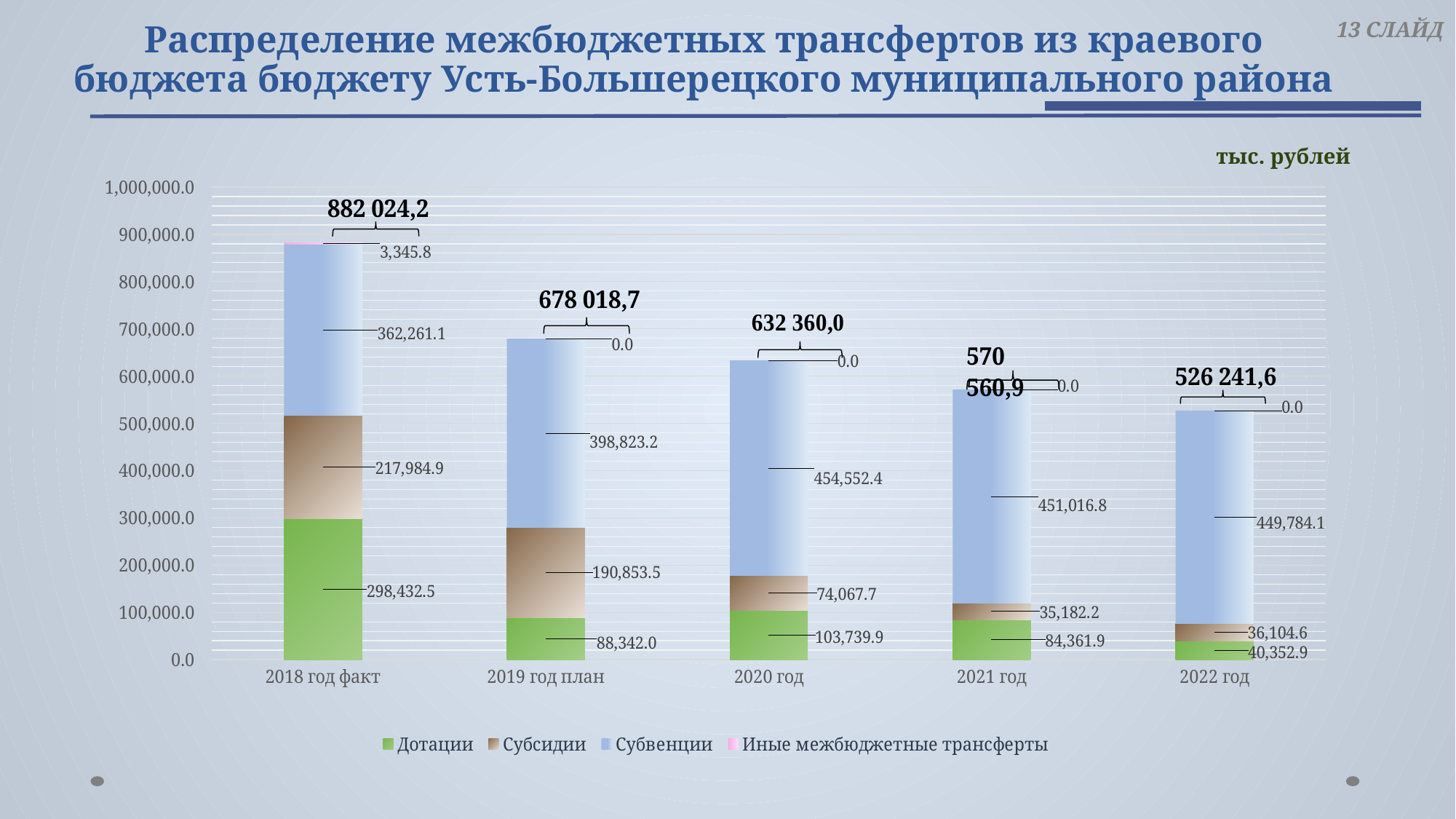
What is the value of Субсидии for 2021 год? 35,182.2 Which year has the highest total of transfers? 2018 год факт What is the total of the stacked bar for 2022 год? 526 241,6 How many series does the legend list? 4 How many year categories are shown on the x axis? 5 What is the value of Иные межбюджетные трансферты for 2018 год факт? 3,345.8 What is the value of Субвенции for 2020 год? 454,552.4 What is the value of Дотации for 2018 год факт? 298,432.5 Which year has the lowest value of Дотации? 2022 год Do the total transfers rise or fall from 2018 год факт to 2022 год? Fall What is the difference between the Субсидии values for 2019 год план and 2020 год? 116,785.8 What type of chart is shown on the slide? Stacked bar chart